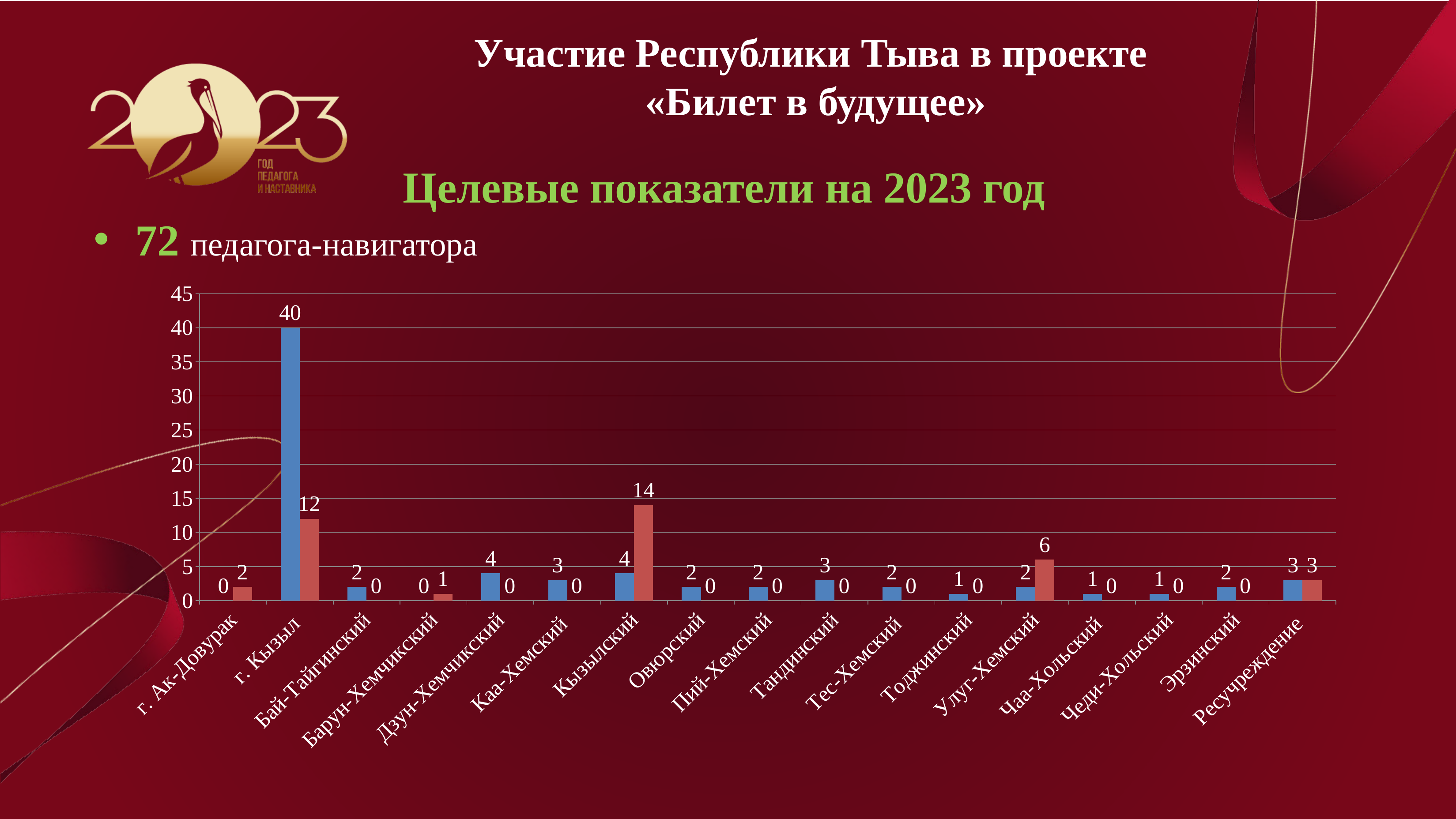
What is the difference between the blue and red bars for г. Кызыл? 28 What is the value of the blue bar for Дзун-Хемчикский? 4 Which is larger for Кызылский: the blue bar or the red bar? the red bar How many categories are shown on the x axis of the chart? 17 What is the value of the red bar for г. Кызыл? 12 What is the value of the red bar for Улуг-Хемский? 6 What type of chart is shown on the slide? bar chart What is the value of the red bar for Ресучреждение? 3 What is the value of the blue bar for г. Кызыл? 40 Which category has the highest blue bar? г. Кызыл Which category has the highest red bar? Кызылский What is the value of the red bar for Кызылский? 14